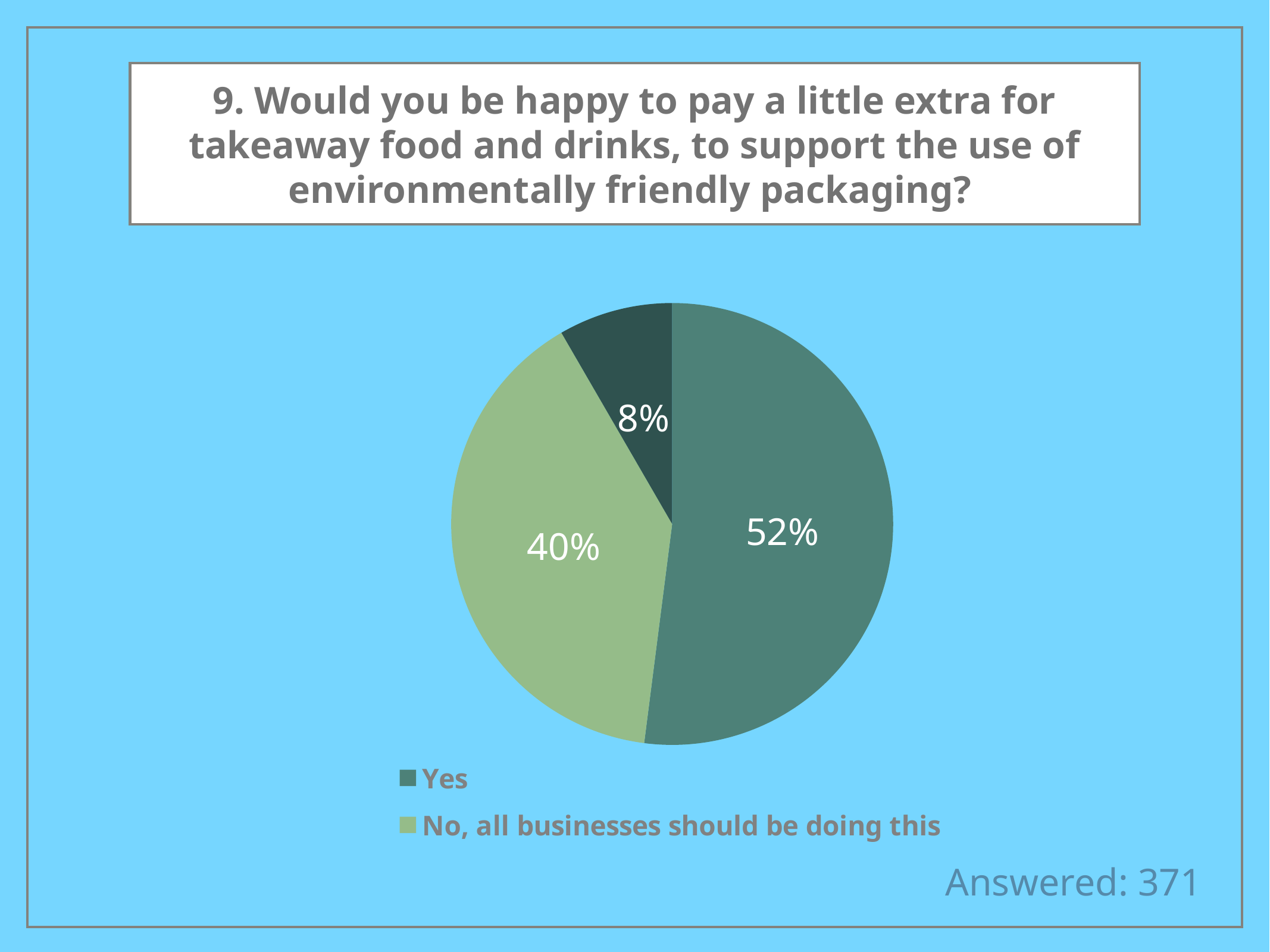
How many people answered this question, according to the slide? 371 What kind of chart is shown on the slide? pie chart Which response has the largest share of the pie? Yes What percentage of respondents answered "Yes"? 52% How many slices does the pie chart have? 3 What is the combined share of the "Yes" and "No, all businesses should be doing this" slices? 92% How many entries does the legend list? 2 What percentage is shown on the smallest slice of the pie? 8% Which is larger: the share for "Yes" or the share for "No, all businesses should be doing this"? Yes What is the question number shown in the chart title? 9 What is the difference in percentage points between the "Yes" slice and the "No, all businesses should be doing this" slice? 12 What percentage of respondents answered "No, all businesses should be doing this"? 40%